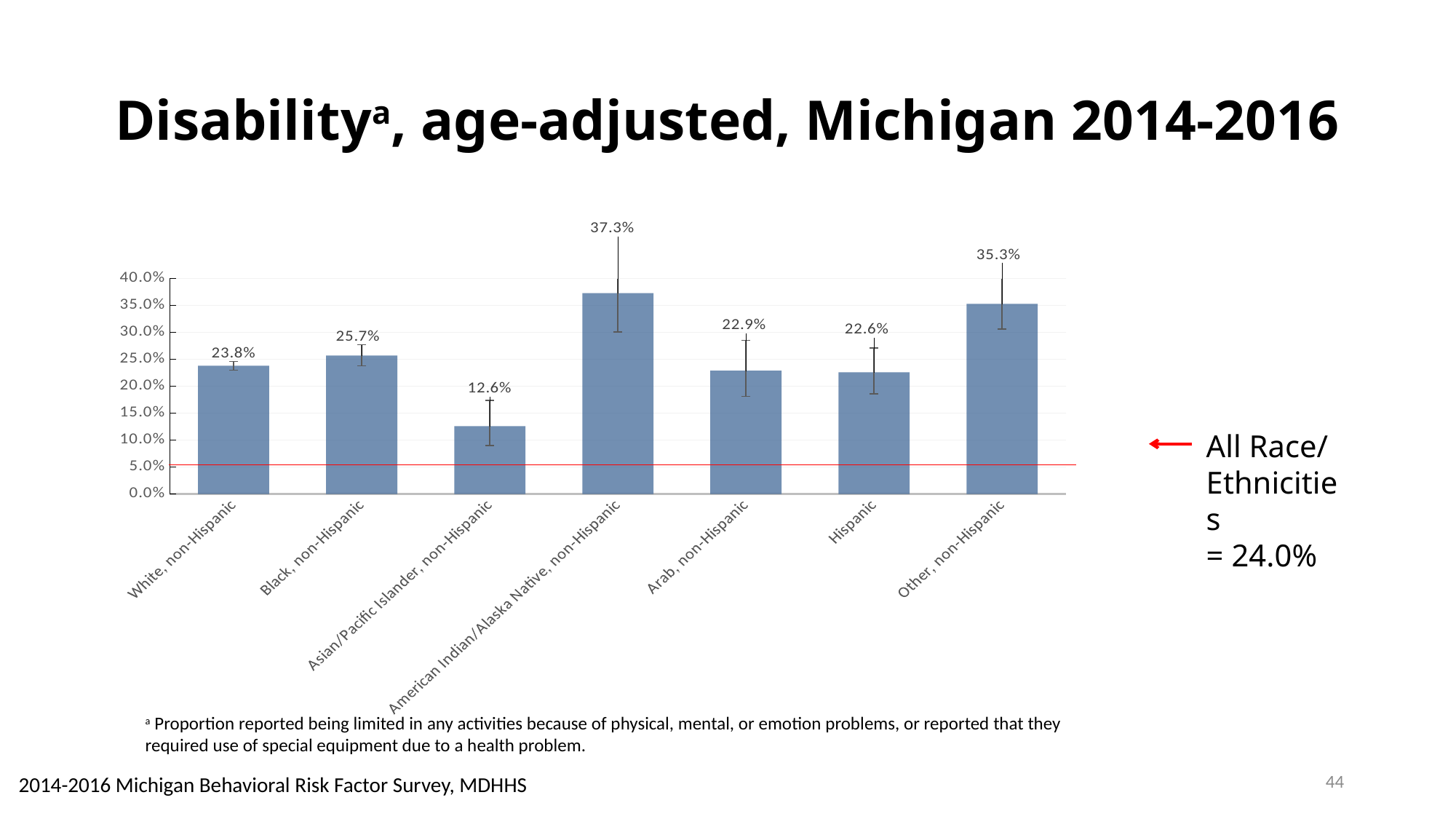
Which has a higher disability percentage, Arab, non-Hispanic or Other, non-Hispanic? Other, non-Hispanic What is the age-adjusted disability percentage for White, non-Hispanic? 23.8% What type of chart is shown on the slide? Bar chart What is the age-adjusted disability percentage for American Indian/Alaska Native, non-Hispanic? 37.3% What is the age-adjusted disability percentage for Other, non-Hispanic? 35.3% What is the difference between the disability percentages for Black, non-Hispanic and White, non-Hispanic? 1.9% Which race/ethnicity group has the lowest disability percentage? Asian/Pacific Islander, non-Hispanic What is the difference between the disability percentages for American Indian/Alaska Native, non-Hispanic and Asian/Pacific Islander, non-Hispanic? 24.7% What is the age-adjusted disability percentage for Hispanic? 22.6% How many race/ethnicity categories are shown in the chart? 7 Which race/ethnicity group has the highest disability percentage? American Indian/Alaska Native, non-Hispanic What is the All Race/Ethnicities disability percentage indicated by the red line? 24.0%